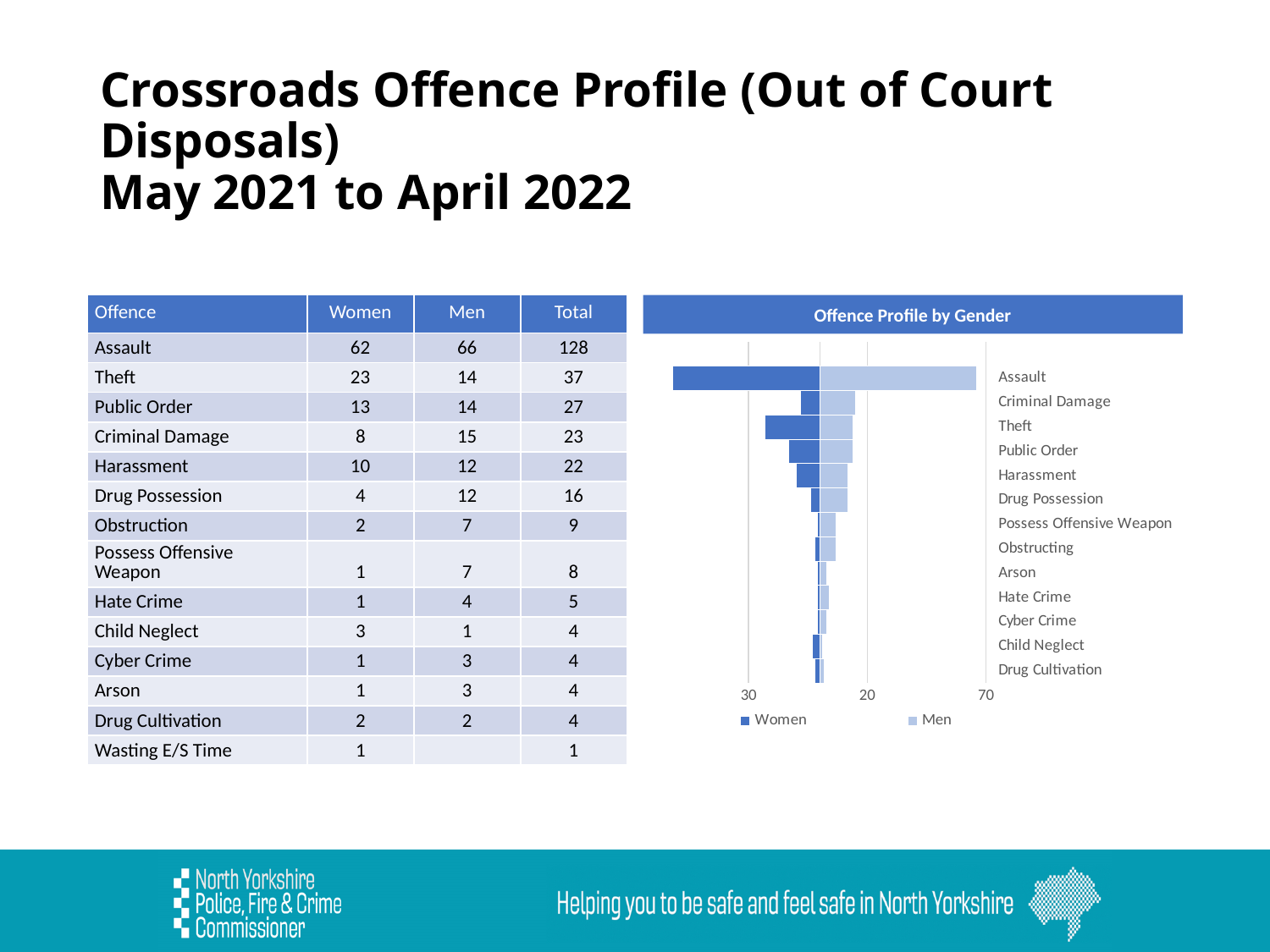
According to the slide, what is the Men value for Assault plotted in the 'Offence Profile by Gender' chart? 66 According to the slide, what is the total of the Women and Men values for Assault in the 'Offence Profile by Gender' chart? 128 What are the legend entries of the 'Offence Profile by Gender' chart? Women, Men What kind of chart is the 'Offence Profile by Gender' chart? bar chart What is the title of the chart on the slide? Offence Profile by Gender In the 'Offence Profile by Gender' chart, which has the larger combined bar, Assault or Theft? Assault According to the slide, what is the Women value for Assault plotted in the 'Offence Profile by Gender' chart? 62 In the 'Offence Profile by Gender' chart, which offence has the longest bar overall? Assault How many series does the legend of the 'Offence Profile by Gender' chart list? 2 How many offence categories are shown in the 'Offence Profile by Gender' chart? 13 In the 'Offence Profile by Gender' chart, is the Women bar or the Men bar longer for Theft? Women In the 'Offence Profile by Gender' chart, is the Women bar or the Men bar longer for Drug Possession? Men